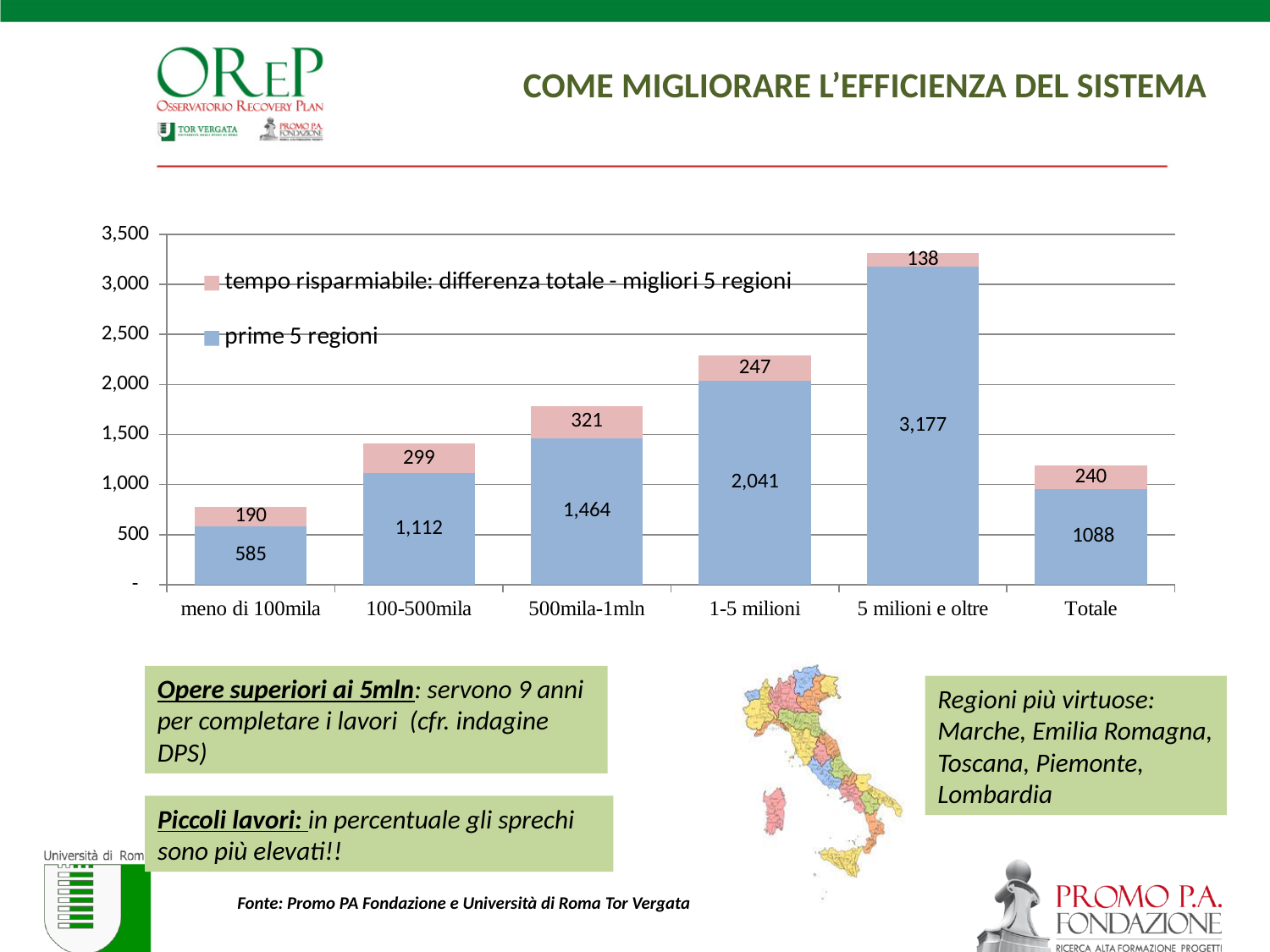
What is the value of the 'prime 5 regioni' series for the 'Totale' category? 1088 How many series does the chart legend list? 2 How many categories are shown on the x axis of the chart? 6 What is the total height of the stacked bar for '5 milioni e oltre'? 3,315 What kind of chart is shown on the slide? Stacked bar chart Which category has the lowest value for the 'tempo risparmiabile: differenza totale - migliori 5 regioni' series? 5 milioni e oltre What is the value of the 'tempo risparmiabile: differenza totale - migliori 5 regioni' series for the '500mila-1mln' category? 321 Which category has the larger 'tempo risparmiabile' value: '100-500mila' or '1-5 milioni'? 100-500mila What is the difference between the 'prime 5 regioni' values for '100-500mila' and 'meno di 100mila'? 527 What is the total height of the stacked bar for 'meno di 100mila'? 775 What is the value of the 'prime 5 regioni' series for the '1-5 milioni' category? 2,041 Which category has the highest value for the 'prime 5 regioni' series? 5 milioni e oltre